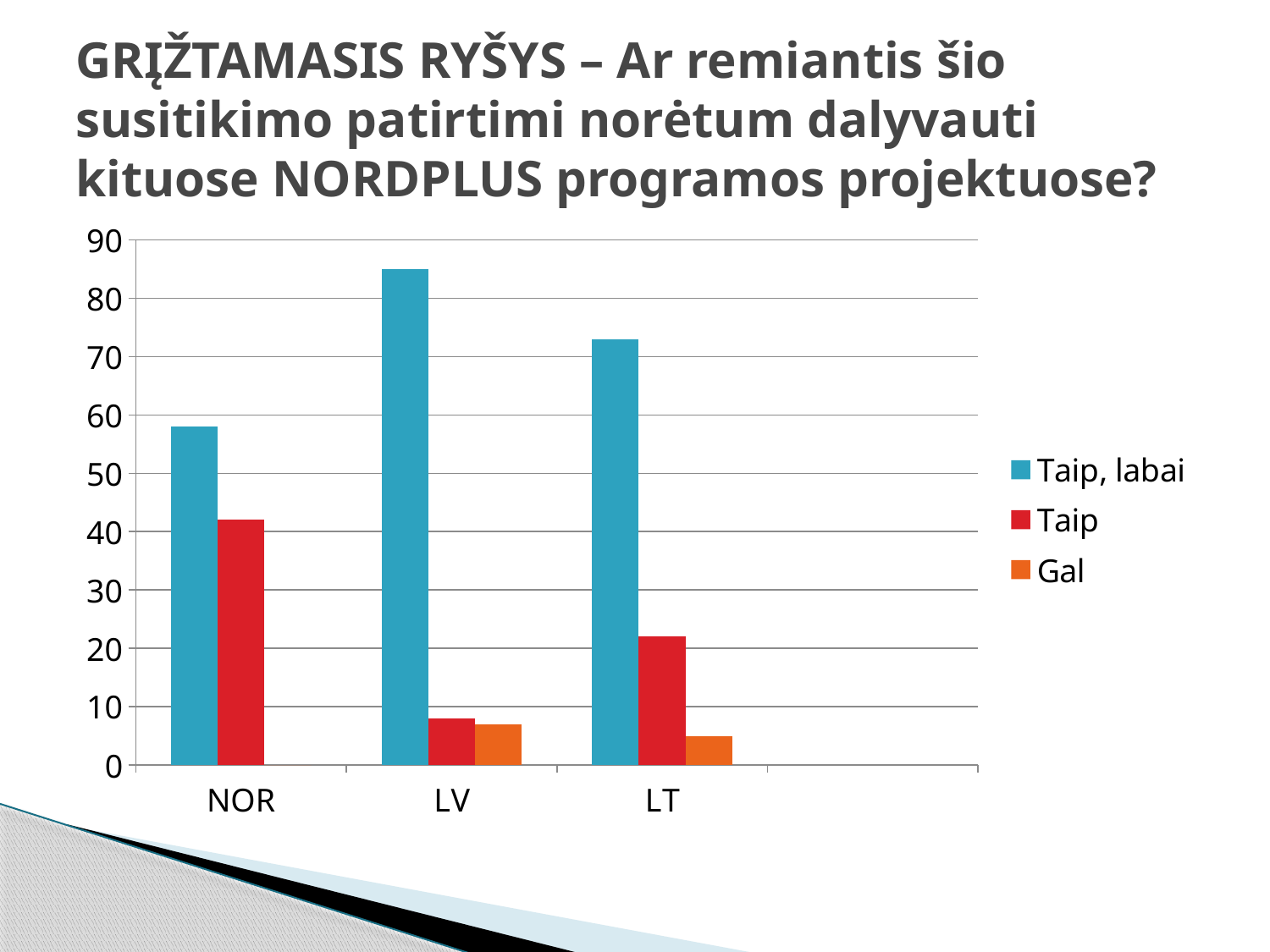
Which category has the highest value for the "Taip" series? NOR How many series does the legend list? 3 Is the "Taip" value for LT greater or less than 30? less Which category has the lowest value for the "Taip, labai" series? NOR What are the three entries listed in the legend? Taip, labai; Taip; Gal Which category has the lowest value for the "Taip" series? LV Is the "Taip, labai" value for NOR greater or less than 50? greater What kind of chart is shown on the slide? bar chart Which is larger: the "Taip, labai" value for LV or for LT? LV Which category has the highest value for the "Taip, labai" series? LV Is the "Taip, labai" value for LV greater or less than 80? greater How many categories are shown on the x axis? 3